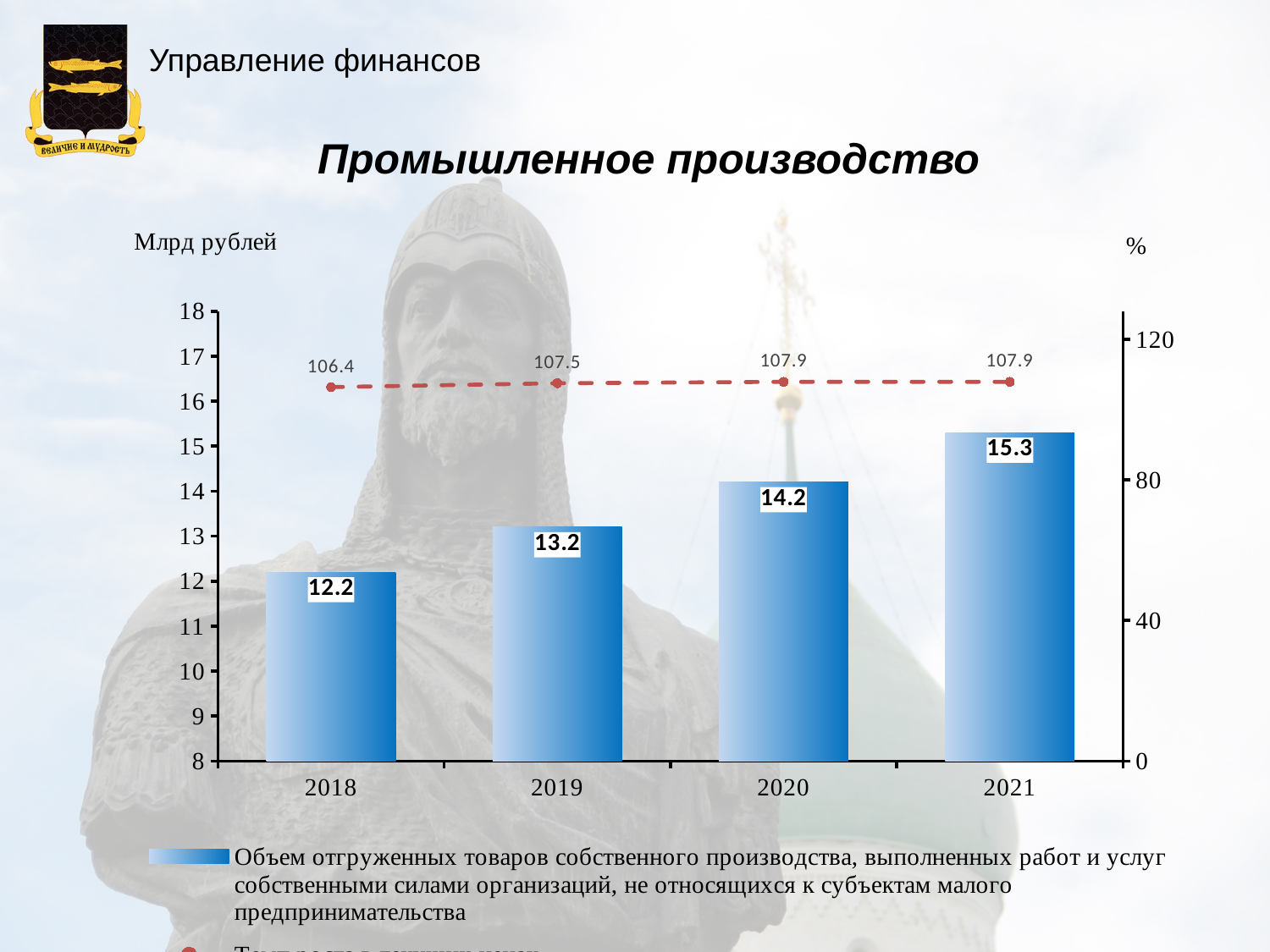
What is the title of the chart on the slide? Промышленное производство What is the value of the bar for 2021? 15.3 What is the value of the bar for 2018? 12.2 What value does the dashed line show for 2020? 107.9 Which year has the highest bar value? 2021 Which year has the lowest value on the dashed line? 2018 What is the difference between the bar values for 2021 and 2018? 3.1 What value does the dashed line show for 2018? 106.4 What unit is shown on the left vertical axis? Млрд рублей Do the bar values rise or fall from 2018 to 2021? rise How many years are shown on the x axis? 4 Which is larger, the bar value for 2019 or for 2020? 2020